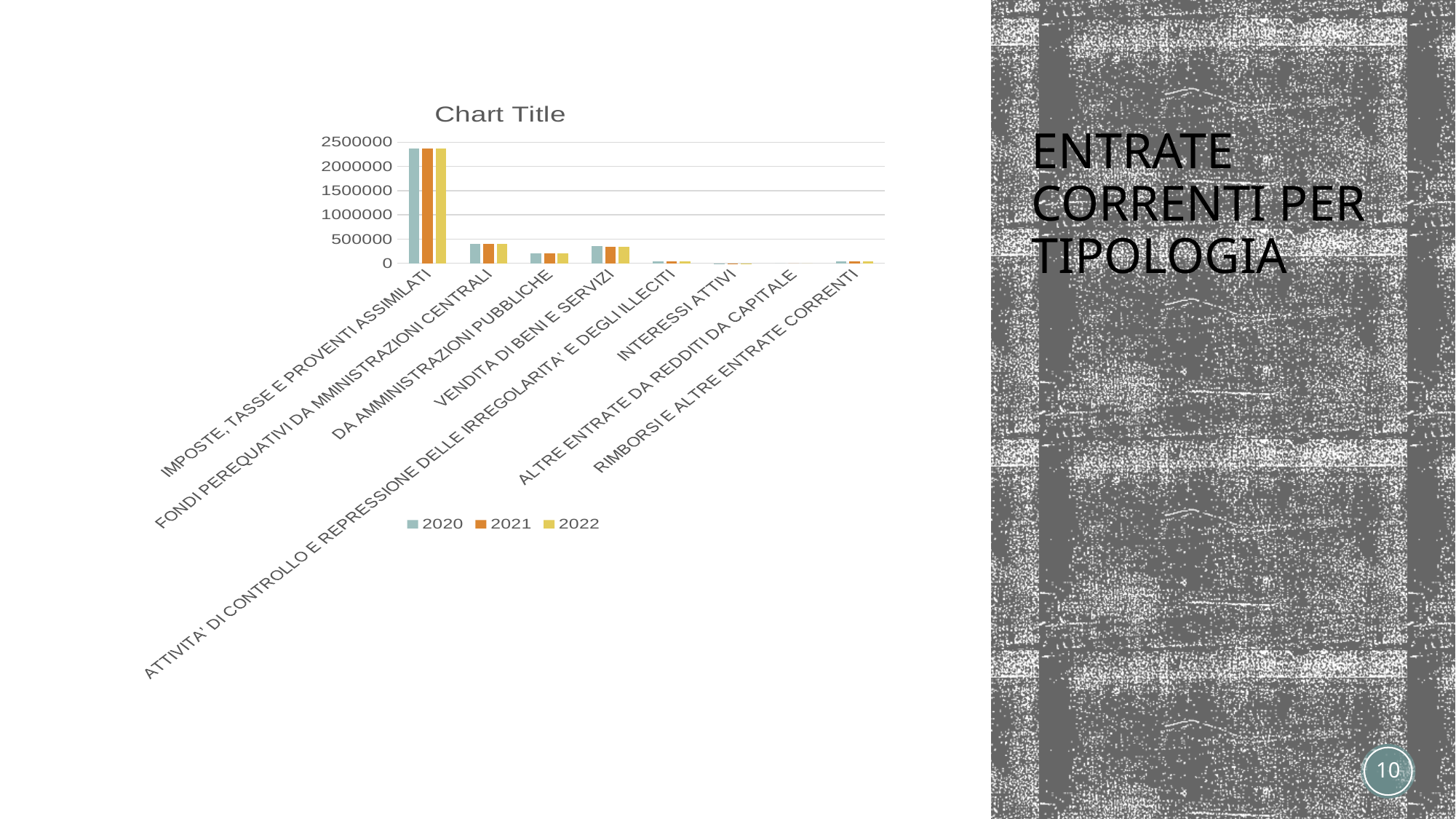
Is the 2022 value for DA AMMINISTRAZIONI PUBBLICHE greater or less than 500000? less Which is larger in 2022: the value for VENDITA DI BENI E SERVIZI or the value for DA AMMINISTRAZIONI PUBBLICHE? VENDITA DI BENI E SERVIZI Which is larger in 2020: the value for FONDI PEREQUATIVI DA MMINISTRAZIONI CENTRALI or the value for DA AMMINISTRAZIONI PUBBLICHE? FONDI PEREQUATIVI DA MMINISTRAZIONI CENTRALI What kind of chart is shown on the slide? Bar chart Is the 2020 value for IMPOSTE, TASSE E PROVENTI ASSIMILATI greater or less than 2000000? greater Which category has the highest values in the chart? IMPOSTE, TASSE E PROVENTI ASSIMILATI What is the title shown above the chart? Chart Title How many categories are shown on the x axis of the chart? 8 How many series does the chart's legend list? 3 Is the 2021 value for FONDI PEREQUATIVI DA MMINISTRAZIONI CENTRALI greater or less than 500000? less Which years are listed in the chart's legend? 2020, 2021, 2022